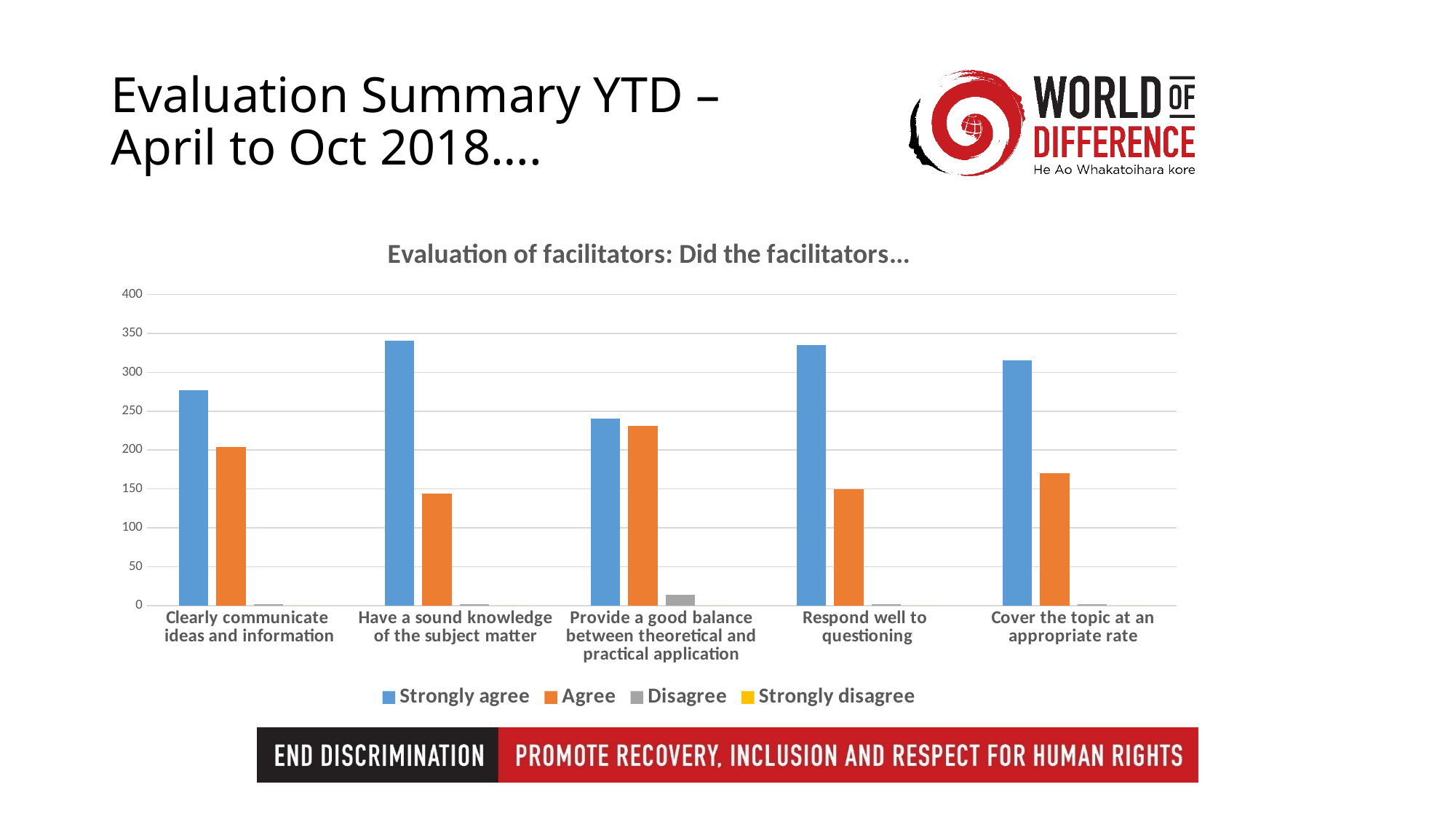
What kind of chart is shown on the slide? Bar chart Which category has the lowest Strongly agree value? Provide a good balance between theoretical and practical application Which series is shown in orange in the legend? Agree How many series does the legend list? 4 Which is larger for Clearly communicate ideas and information: the Strongly agree value or the Agree value? Strongly agree How many categories are shown on the x axis? 5 Which category has the highest Disagree value? Provide a good balance between theoretical and practical application Is the Strongly agree value for Cover the topic at an appropriate rate greater or less than 300? greater Which category has the highest Agree value? Provide a good balance between theoretical and practical application What is the title of the chart? Evaluation of facilitators: Did the facilitators... Is the Strongly agree value for Clearly communicate ideas and information greater or less than 250? greater